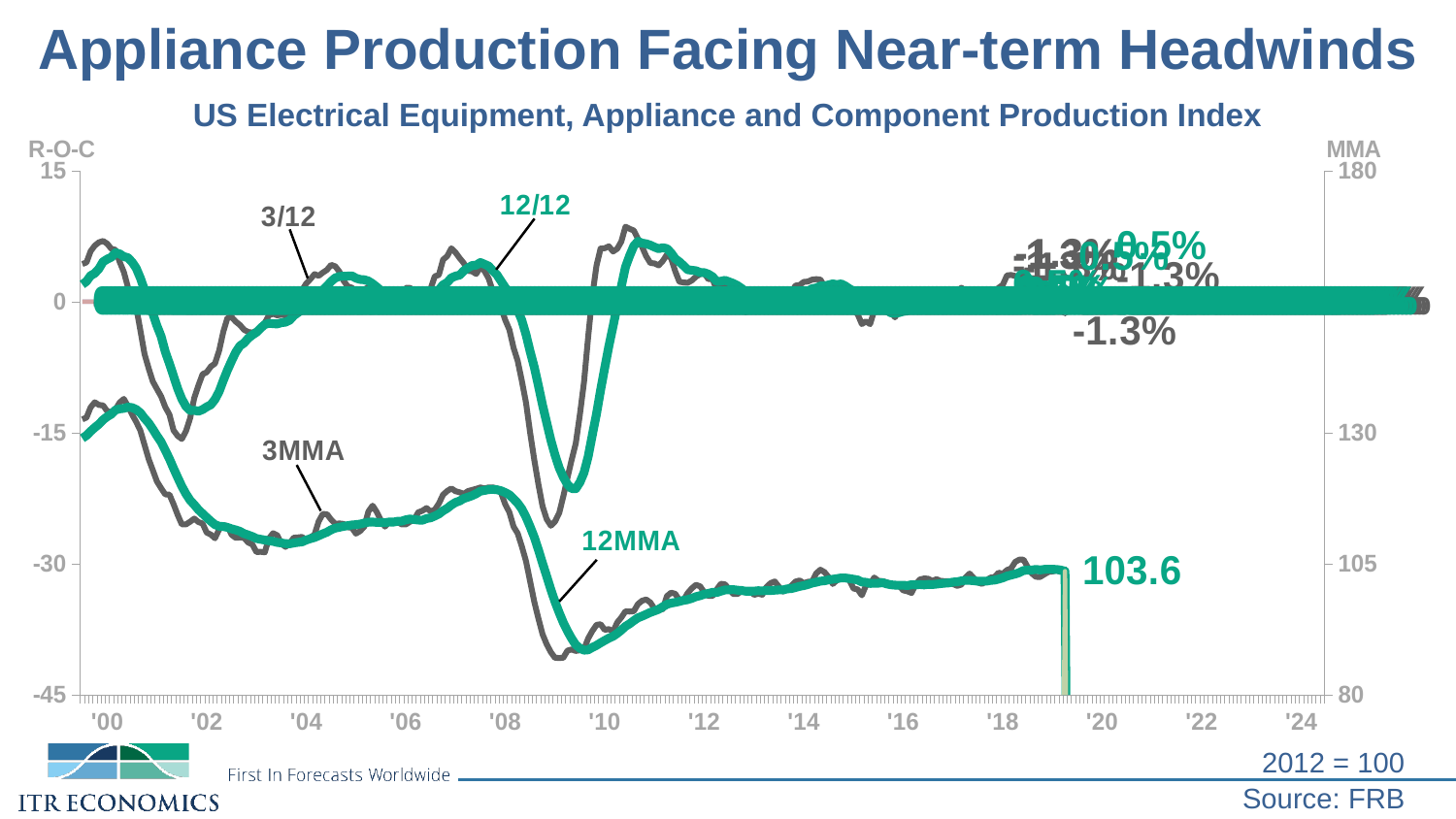
What kind of chart is shown on the slide? line chart Is the 12/12 rate-of-change at its 2009 trough greater or less than -15? less Is the 3MMA value in 2003 greater or less than 130 on the right axis? less Does the 12MMA series rise or fall between 2010 and 2018? rise Does the 12MMA series rise or fall between 2008 and 2009? fall What is the latest value labeled for the 12MMA series? 103.6 What is the title of the chart? US Electrical Equipment, Appliance and Component Production Index Is the 12MMA value in 2000 greater or less than 130 on the right axis? greater Which year is the index base year, according to the note on the slide? 2012 = 100 How many labeled series are plotted on the chart? 4